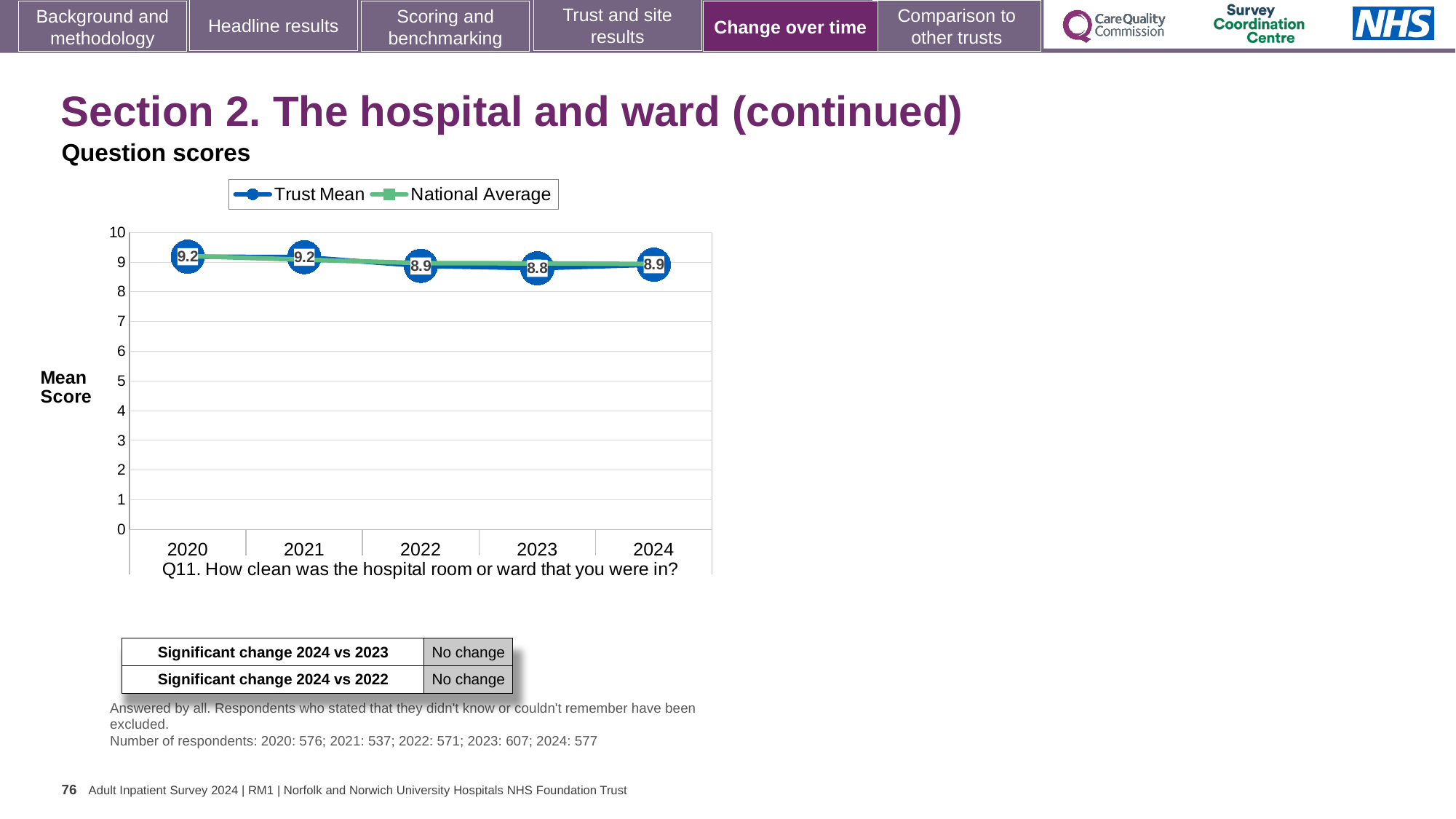
What is the Trust Mean score for 2024? 8.9 Does the Trust Mean score rise or fall from 2020 to 2024? fall Which year has the higher Trust Mean score, 2021 or 2022? 2021 What is the Trust Mean score for 2020? 9.2 What kind of chart is shown on the slide? line chart How many years are plotted on the x axis? 5 Which survey question does the chart show scores for? Q11. How clean was the hospital room or ward that you were in? What is the difference between the Trust Mean scores for 2020 and 2023? 0.4 How many series does the legend list? 2 In which year is the Trust Mean score lowest? 2023 What is the Trust Mean score for 2023? 8.8 Is the National Average value for 2024 greater or less than 5? greater